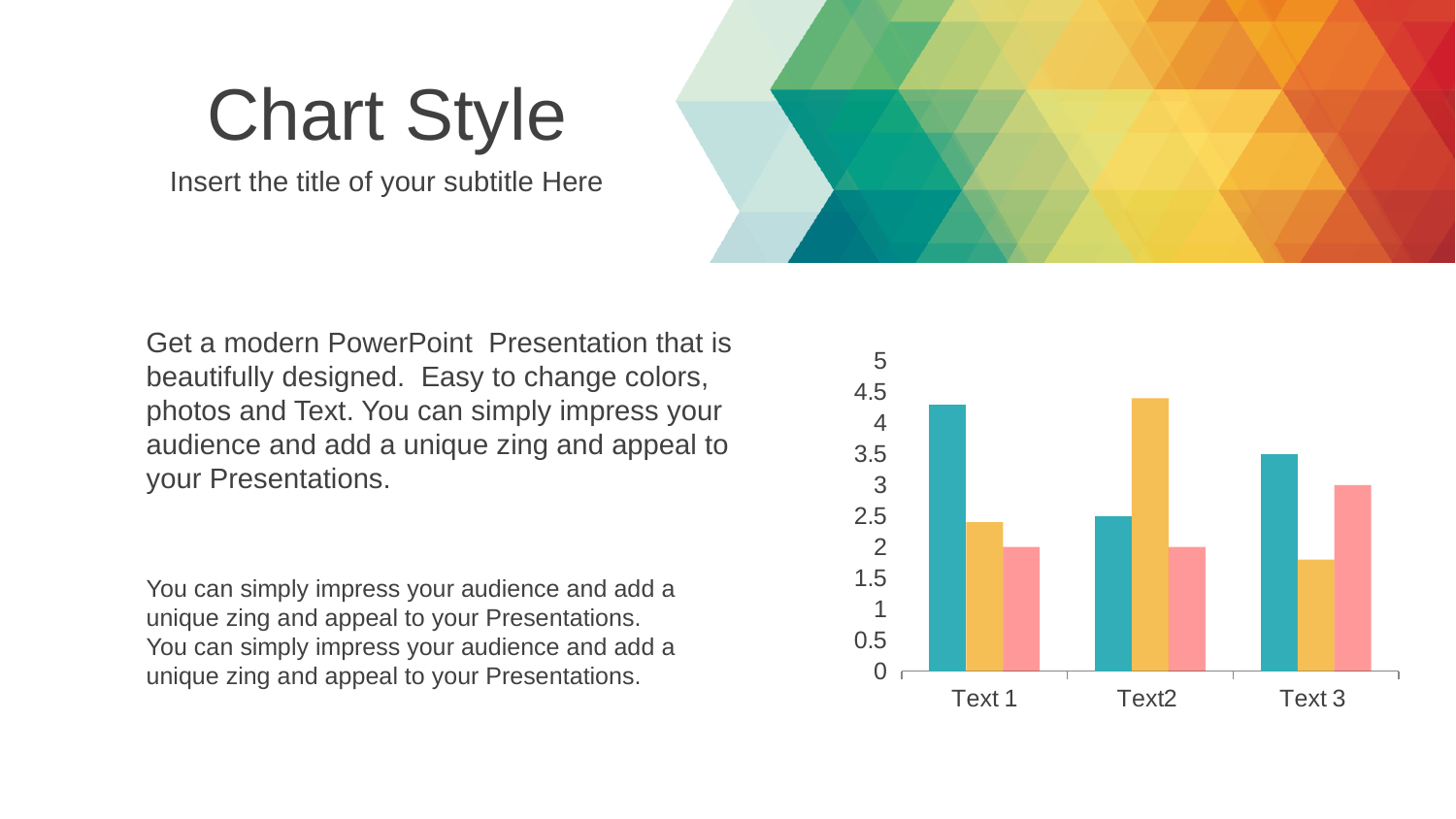
How many bars are plotted for each category in the chart? 3 Which category has the tallest yellow bar? Text2 Is the value of the pink bar for Text 3 greater or less than 2.5? greater How many categories are shown on the x axis of the chart? 3 Is the value of the teal bar for Text 1 greater or less than 4? greater Which category has the tallest pink bar? Text 3 Is the value of the teal bar for Text2 greater or less than 3? less Which category has the tallest teal bar? Text 1 Which is larger: the teal bar for Text 3 or the teal bar for Text2? the teal bar for Text 3 What kind of chart is shown on the slide? bar chart